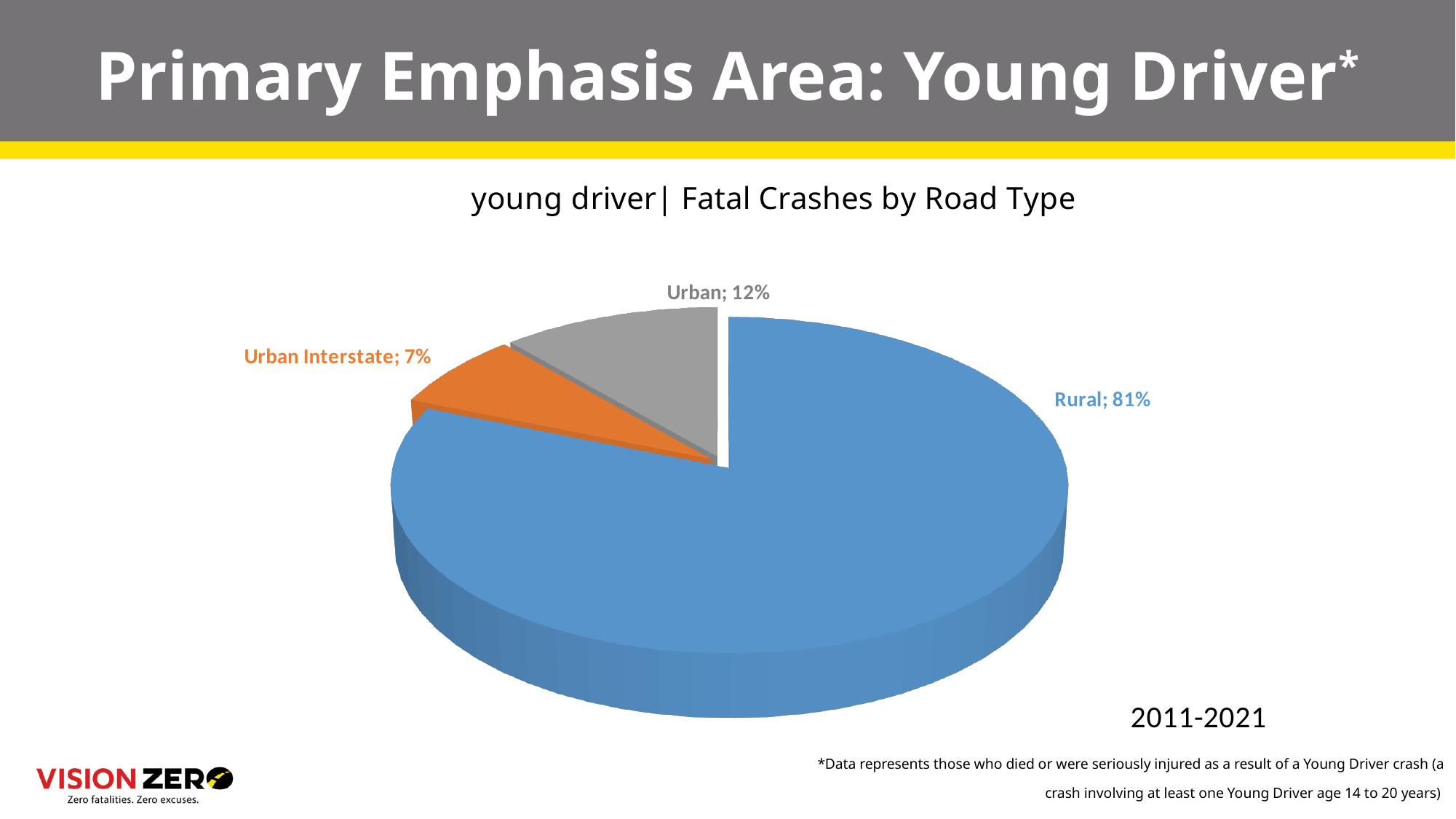
What share of young driver fatal crashes occurred on Rural roads? 81% Which road type has the largest share of young driver fatal crashes? Rural What kind of chart is shown on the slide? Pie chart Which has a larger share of young driver fatal crashes, Urban or Urban Interstate? Urban How many percentage points larger is the Urban share than the Urban Interstate share? 5 How many percentage points larger is the Rural share than the Urban share? 69 How many road type categories are shown in the pie chart? 3 What share of young driver fatal crashes occurred on Urban roads? 12% Which road type has the smallest share of young driver fatal crashes? Urban Interstate What share of young driver fatal crashes occurred on Urban Interstate roads? 7% What is the title of the chart? young driver| Fatal Crashes by Road Type What time period does the chart cover? 2011-2021